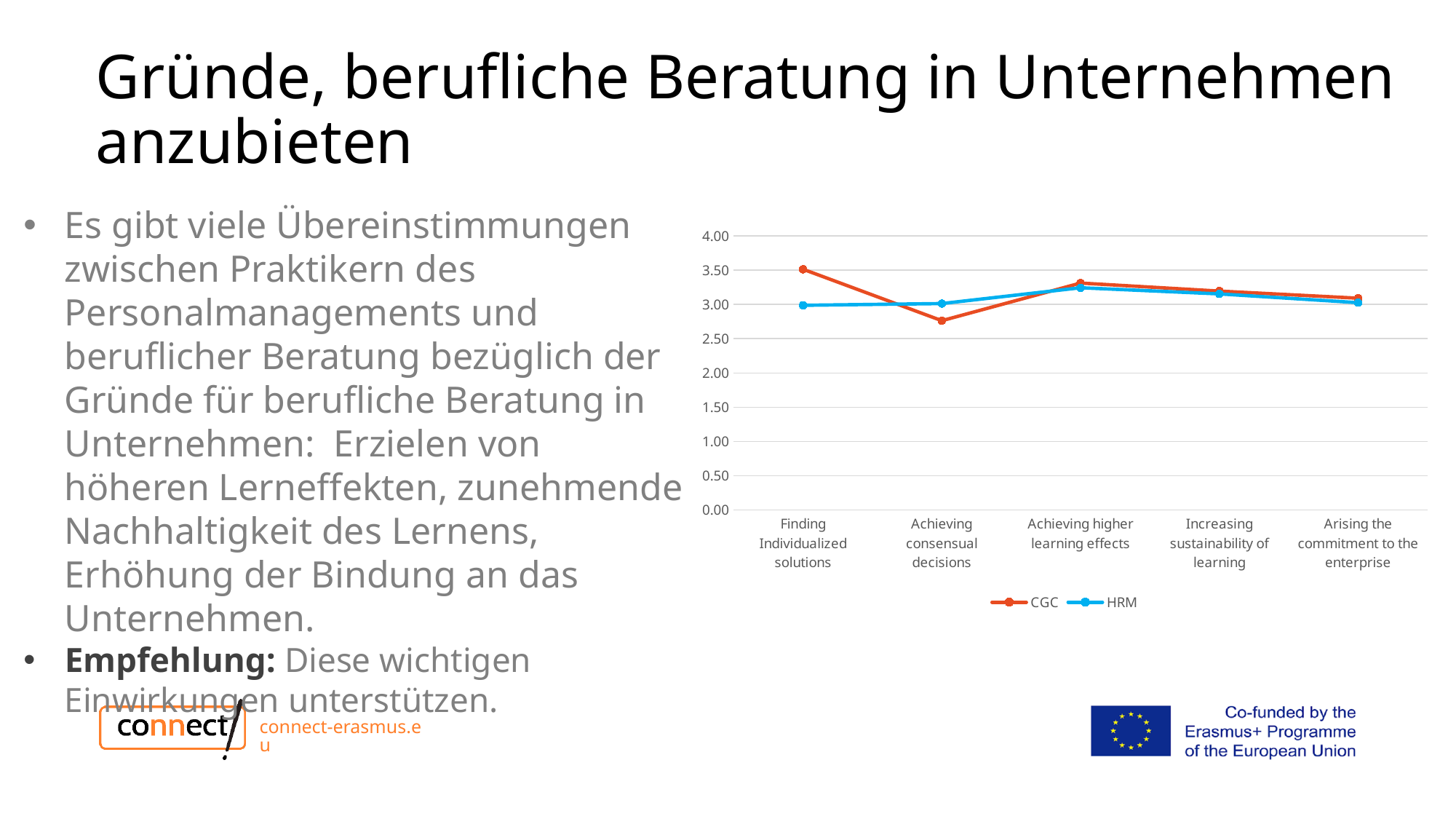
Is the CGC value for Finding Individualized solutions greater or less than 3.00? greater How many series does the chart's legend list? 2 What kind of chart is shown on the slide? line chart How many categories are shown along the x axis of the chart? 5 Which series are listed in the chart's legend? CGC and HRM For Achieving consensual decisions, which series has the larger value, CGC or HRM? HRM Is the CGC value for Achieving consensual decisions greater or less than 3.00? less For which category is the CGC value highest? Finding Individualized solutions What colour is the line for the HRM series? blue For which category is the CGC value lowest? Achieving consensual decisions For Finding Individualized solutions, which series has the larger value, CGC or HRM? CGC Is the HRM value for Achieving higher learning effects greater or less than 3.00? greater